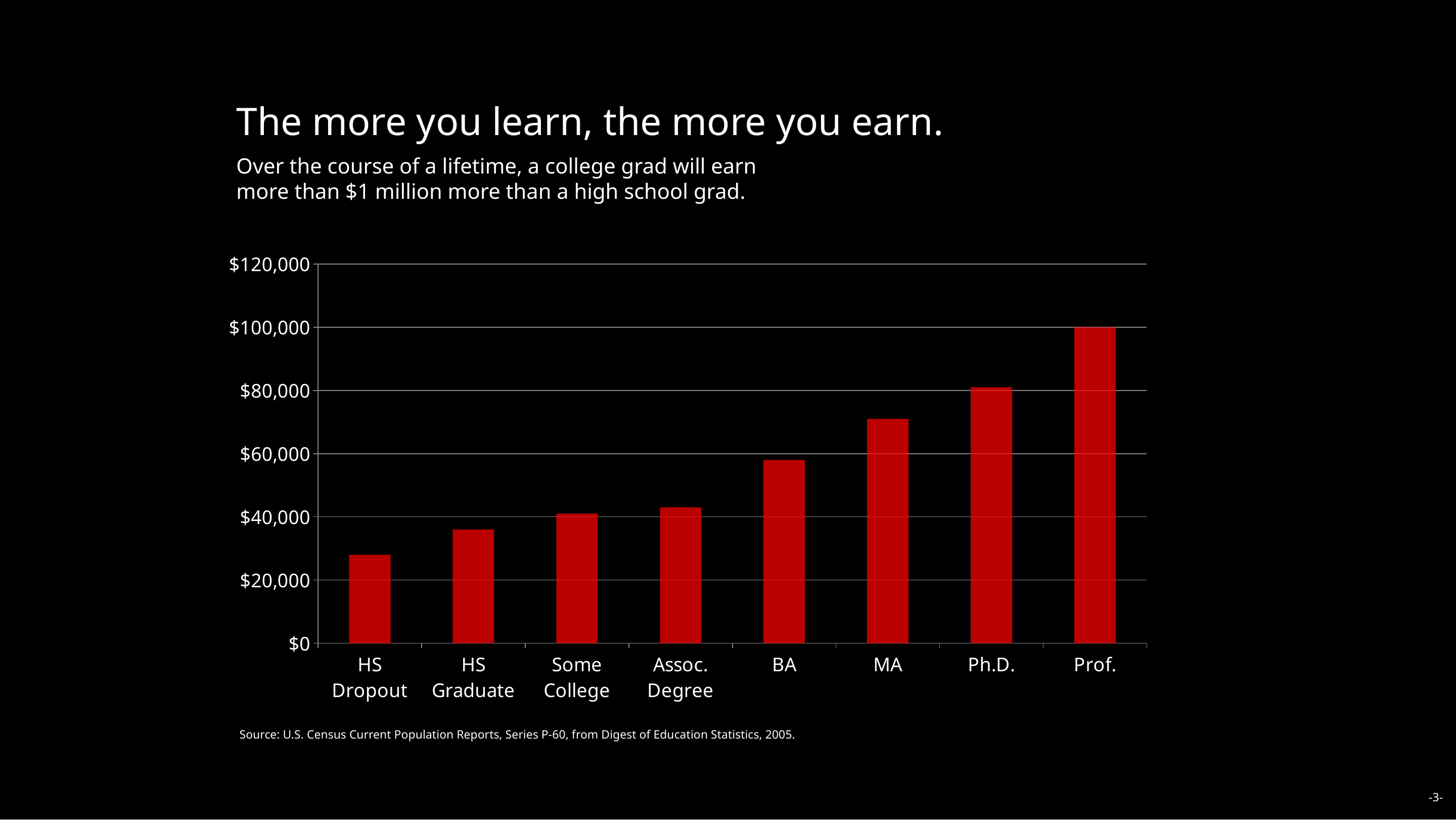
Is the value for HS Dropout greater or less than $40,000? less What is the title of the slide containing the chart? The more you learn, the more you earn. Is the value for Ph.D. greater or less than $100,000? less Which is larger, the value for MA or the value for BA? MA What kind of chart is shown on the slide? bar chart Which education category has the highest value? Prof. Is the value for BA greater or less than $40,000? greater Which education category has the lowest value? HS Dropout What is the value for Prof.? $100,000 How many education categories are shown on the x axis? 8 Do the values rise or fall moving from HS Dropout to Prof. along the x axis? rise